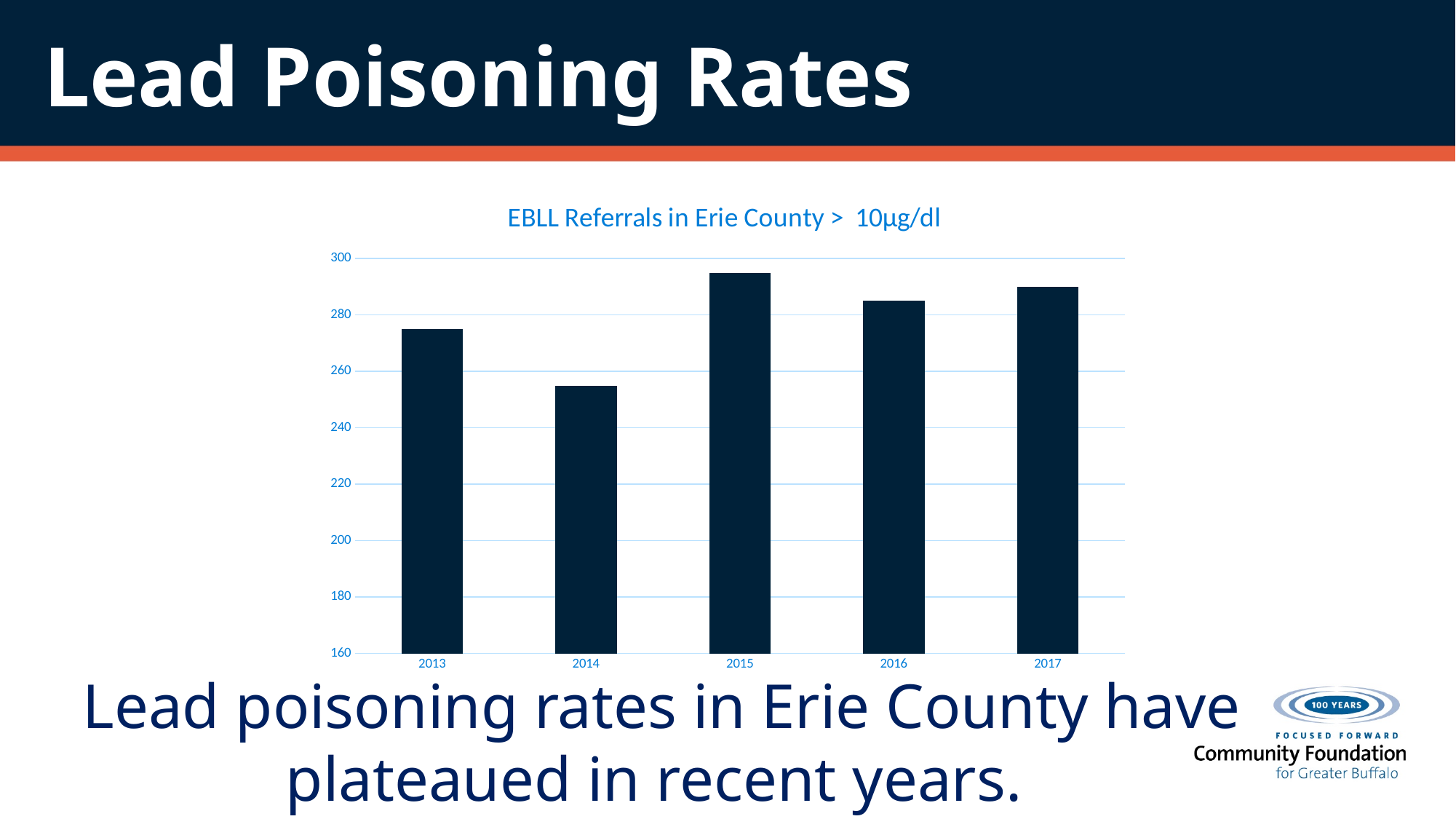
Which year has the lowest number of EBLL referrals? 2014 Is the value for 2013 greater or less than 260? greater Which year has more EBLL referrals, 2013 or 2016? 2016 What kind of chart is shown on the slide? bar chart Which year has the highest number of EBLL referrals? 2015 Which year has more EBLL referrals, 2013 or 2014? 2013 What is the title of the chart? EBLL Referrals in Erie County > 10µg/dl Is the value for 2014 greater or less than 240? greater Is the value for 2016 greater or less than 260? greater From 2014 to 2015, does the number of EBLL referrals rise or fall? rise How many years are plotted on the x axis of the chart? 5